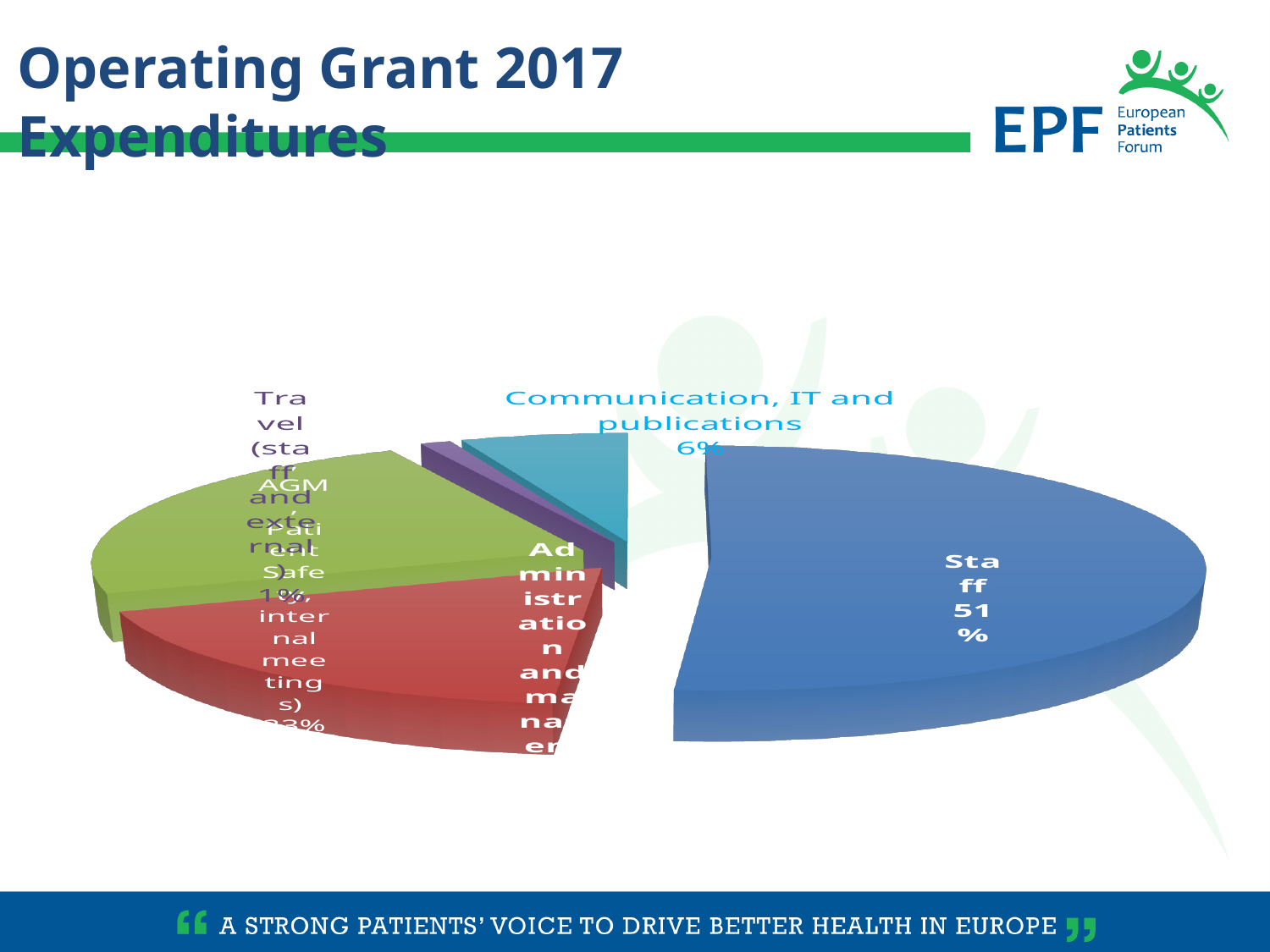
What is the difference in percentage points between the Staff share and the Communication, IT and publications share? 45% Which category has the largest slice of the pie? Staff What share of expenditures goes to Communication, IT and publications? 6% What is the title of the slide containing the pie chart? Operating Grant 2017 Expenditures Is the Staff share greater or less than 50%? greater What share of expenditures goes to Staff? 51% What colour is the Staff slice of the pie chart? blue Which is larger: the Staff slice or the Communication, IT and publications slice? Staff What kind of chart is shown on the slide? pie chart